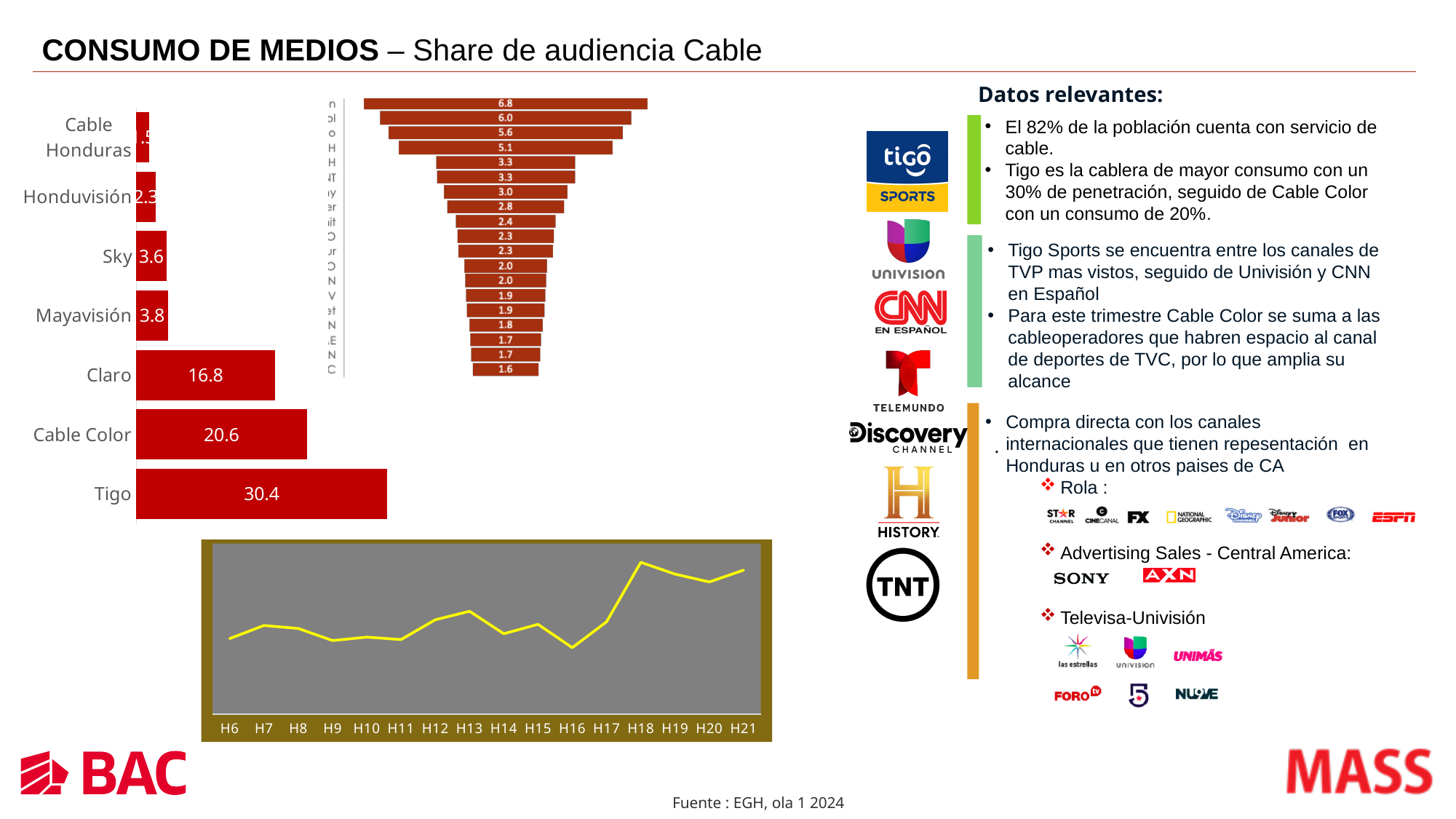
How many bars are in the middle funnel-shaped bar chart? 19 In the bar chart on the left, which cable operator has the highest value? Tigo In the bar chart on the left, what is the value for Claro? 16.8 What kind of chart is the chart on the left showing cable operators? Bar chart In the line chart at the bottom, at which x-axis label does the line reach its highest point? H18 In the bar chart on the left, what is the value for Sky? 3.6 In the bar chart on the left, what is the value for Cable Color? 20.6 In the middle bar chart with the funnel shape, what is the largest value shown? 6.8 In the bar chart on the left, what is the value for Tigo? 30.4 How many cable operators are shown in the bar chart on the left? 7 In the bar chart on the left, what is the difference between Tigo and Cable Color? 9.8 In the bar chart on the left, which is larger, Mayavisión or Honduvisión? Mayavisión